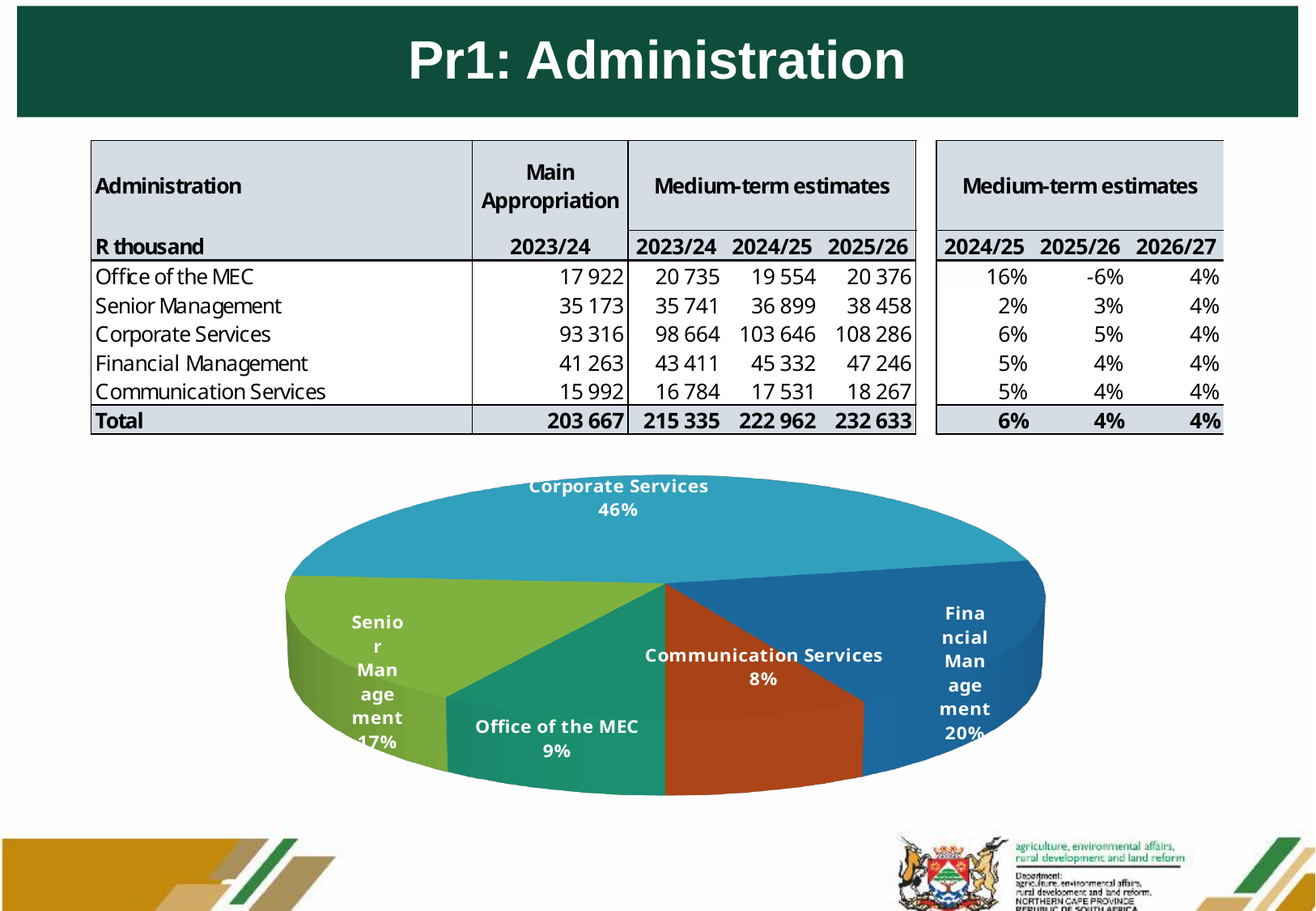
What share of the pie chart does Financial Management represent? 20% In the pie chart, which is larger: Senior Management or Office of the MEC? Senior Management Which slice of the pie chart is the smallest? Communication Services In the pie chart, what is the difference in percentage points between Corporate Services and Financial Management? 26 What share of the pie chart does Office of the MEC represent? 9% What kind of chart is shown on the slide? Pie chart How many slices does the pie chart have? 5 What share of the pie chart does Corporate Services represent? 46% In the pie chart, what colour is the Communication Services slice? Red-brown Which slice of the pie chart is the largest? Corporate Services